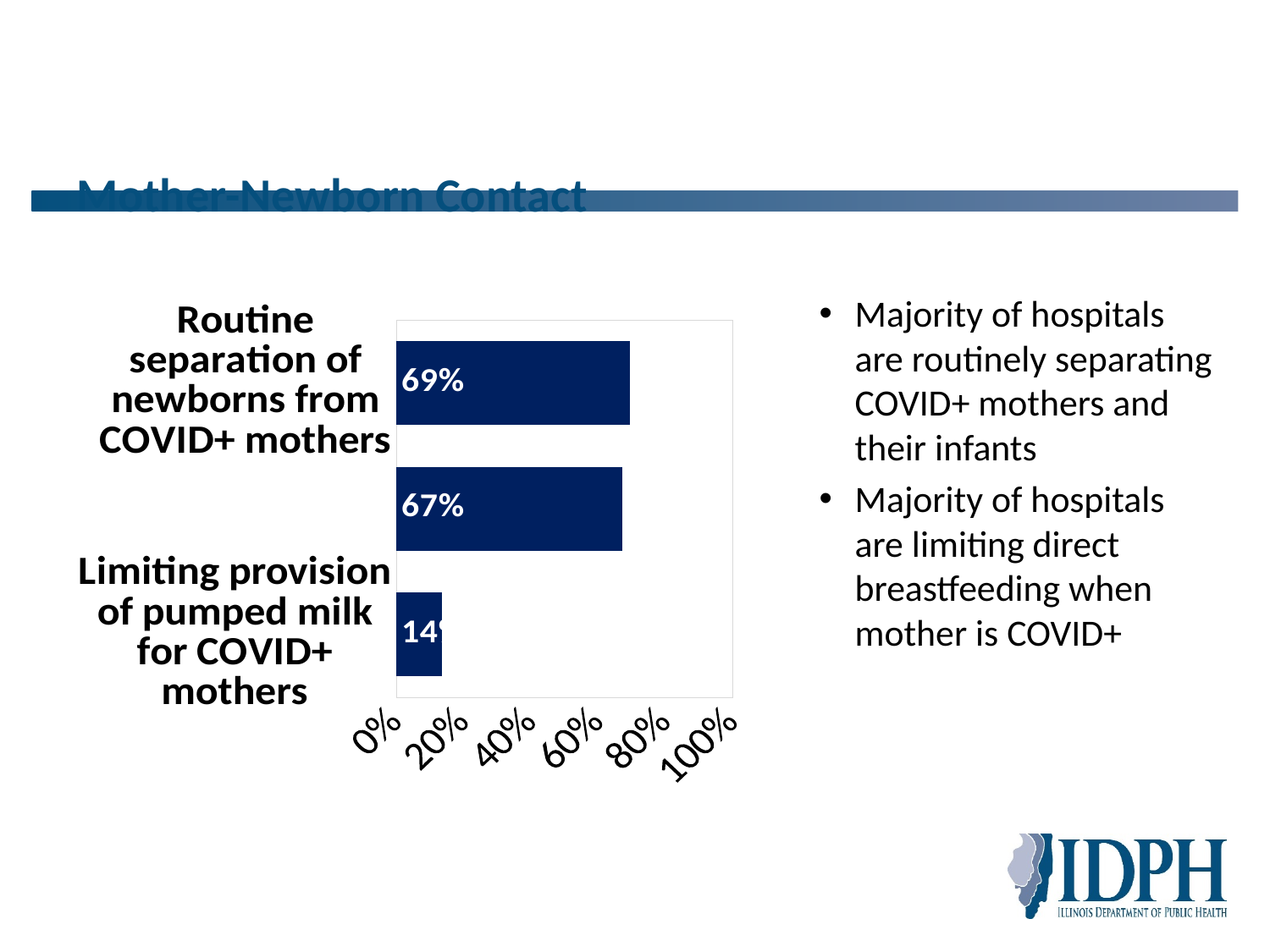
How many bars are plotted in the chart? 3 What percentage of hospitals report routine separation of newborns from COVID+ mothers? 69% What colour are the bars in the chart? Dark navy blue Which category has the highest value in the chart? Routine separation of newborns from COVID+ mothers What value is shown for the middle bar of the chart? 67% Is the value for limiting provision of pumped milk for COVID+ mothers greater or less than 20%? less Which is larger: the value for routine separation of newborns from COVID+ mothers or the value for limiting provision of pumped milk for COVID+ mothers? Routine separation of newborns from COVID+ mothers What is the maximum value shown on the chart's percentage axis? 100% Which category has the lowest value in the chart? Limiting provision of pumped milk for COVID+ mothers What is the difference between the top bar (69%) and the middle bar (67%)? 2 percentage points What type of chart is shown on the slide? Bar chart Is the value for routine separation of newborns from COVID+ mothers greater or less than 60%? greater